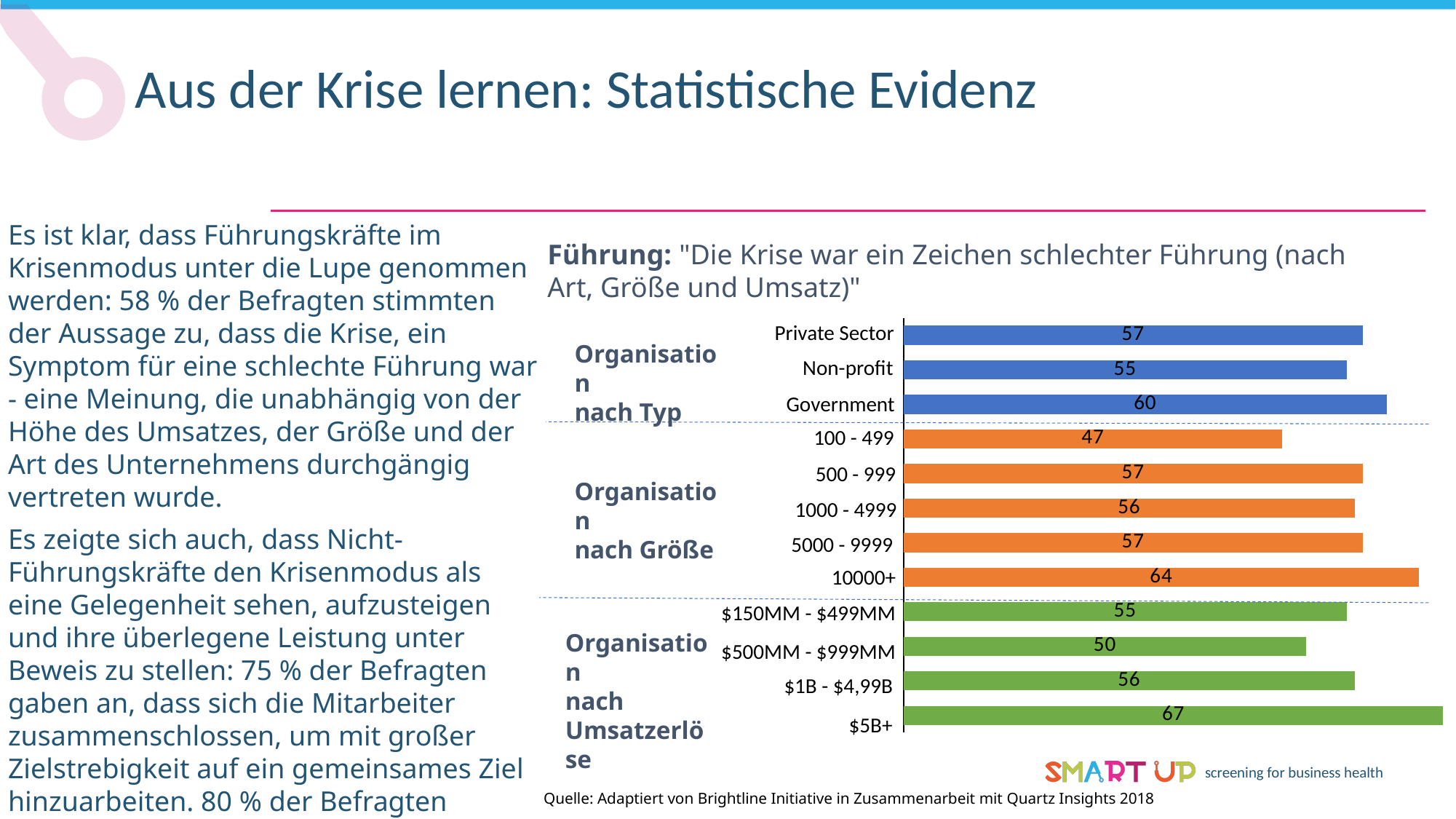
How many categories are plotted in the chart? 12 Which is larger, the value for Private Sector or the value for Non-profit? Private Sector What is the difference between the values for 10000+ and 100 - 499? 17 Which category has the highest value in the chart? $5B+ What is the difference between the values for $5B+ and $1B - $4,99B? 11 Which category has the lowest value in the chart? 100 - 499 What is the value for $5B+? 67 What is the value for Government? 60 What is the value for $500MM - $999MM? 50 What colour are the bars for the 'Organisation nach Größe' group? Orange What kind of chart is shown on the slide? Bar chart What is the value for the 100 - 499 category? 47